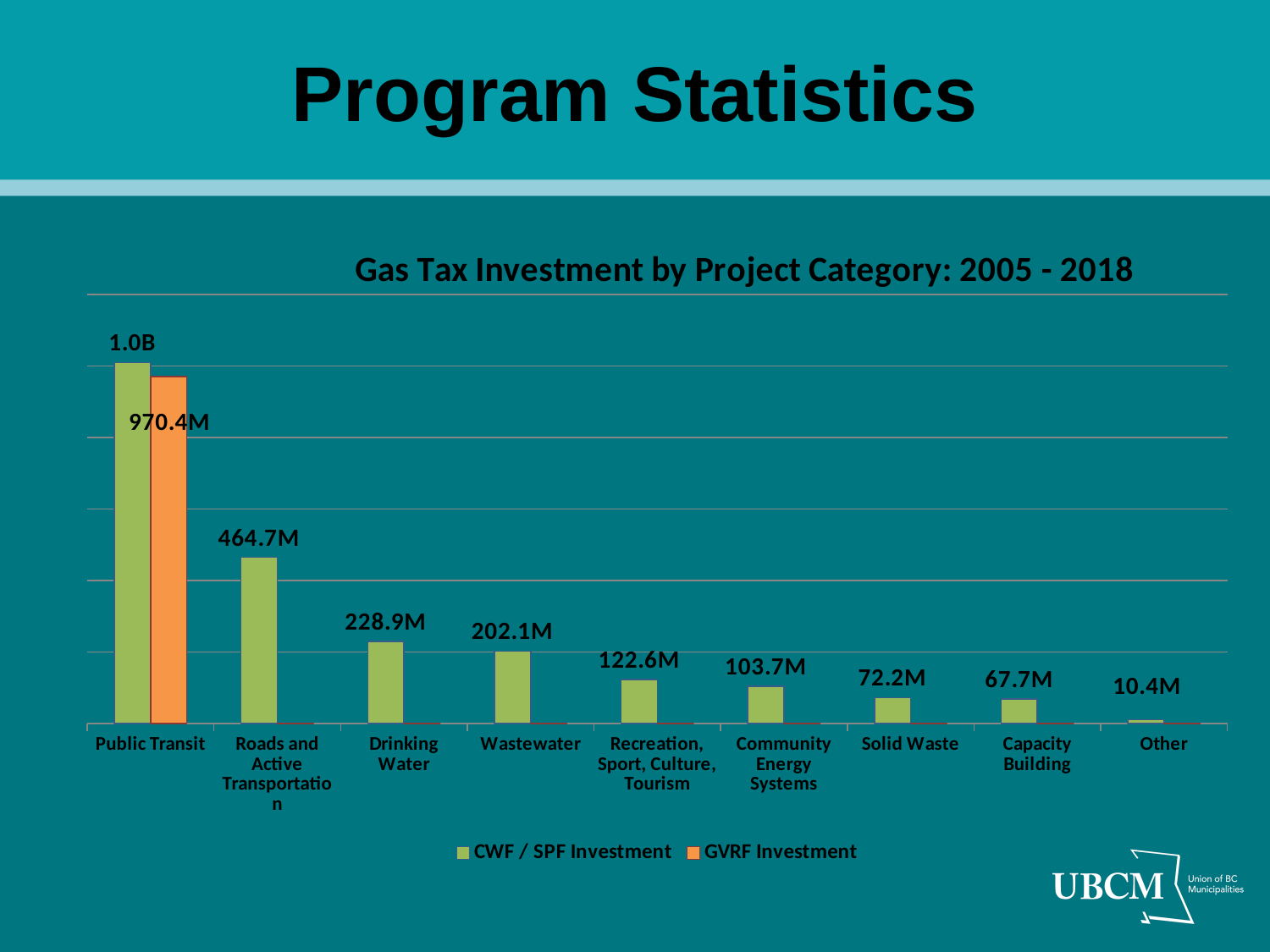
Which project category has the lowest CWF / SPF Investment? Other What type of chart is shown on the slide? Bar chart What is the CWF / SPF Investment value for Community Energy Systems? 103.7M Which project category has the highest CWF / SPF Investment? Public Transit What is the GVRF Investment value for Public Transit? 970.4M How many project categories are shown on the x axis? 9 What is the difference between the CWF / SPF Investment for Roads and Active Transportation and for Drinking Water? 235.8M What is the CWF / SPF Investment value for Roads and Active Transportation? 464.7M What is the difference between the CWF / SPF Investment for Solid Waste and for Capacity Building? 4.5M How many series does the legend list? 2 What is the CWF / SPF Investment value for Drinking Water? 228.9M Which has a larger CWF / SPF Investment, Wastewater or Recreation, Sport, Culture, Tourism? Wastewater